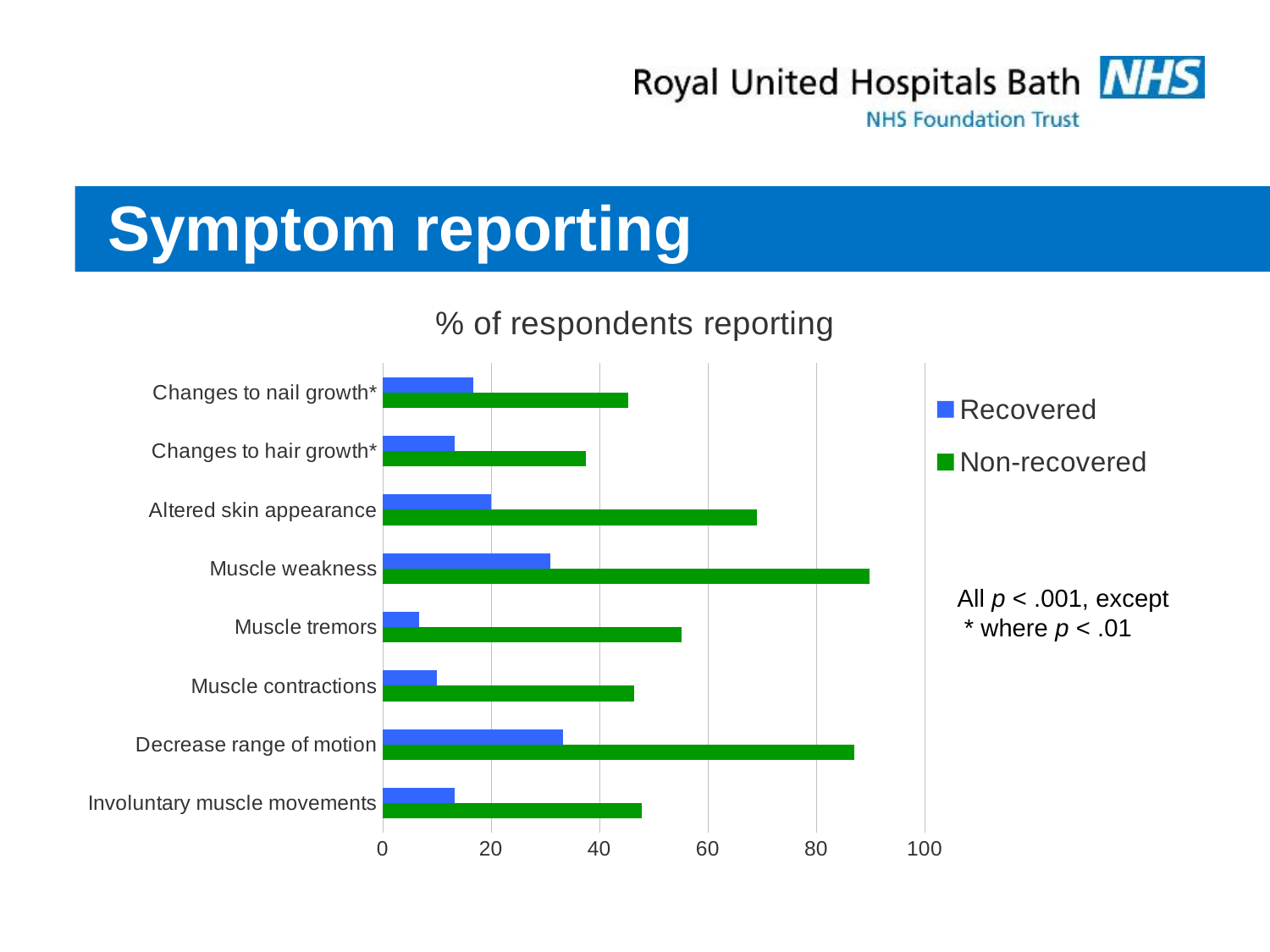
Is the Non-recovered value for Altered skin appearance greater or less than 60? greater Is the Non-recovered value for Muscle weakness greater or less than 80? greater Which is larger: the Non-recovered value for Altered skin appearance or the Non-recovered value for Muscle tremors? Altered skin appearance Which category has the lowest Non-recovered value? Changes to hair growth* For Muscle contractions, which series has the larger value, Recovered or Non-recovered? Non-recovered What is the title of the chart? % of respondents reporting Which category has the lowest Recovered value? Muscle tremors What kind of chart is shown on the slide? bar chart Is the Recovered value for Muscle tremors greater or less than 20? less How many series does the legend list? 2 How many symptom categories are plotted on the chart? 8